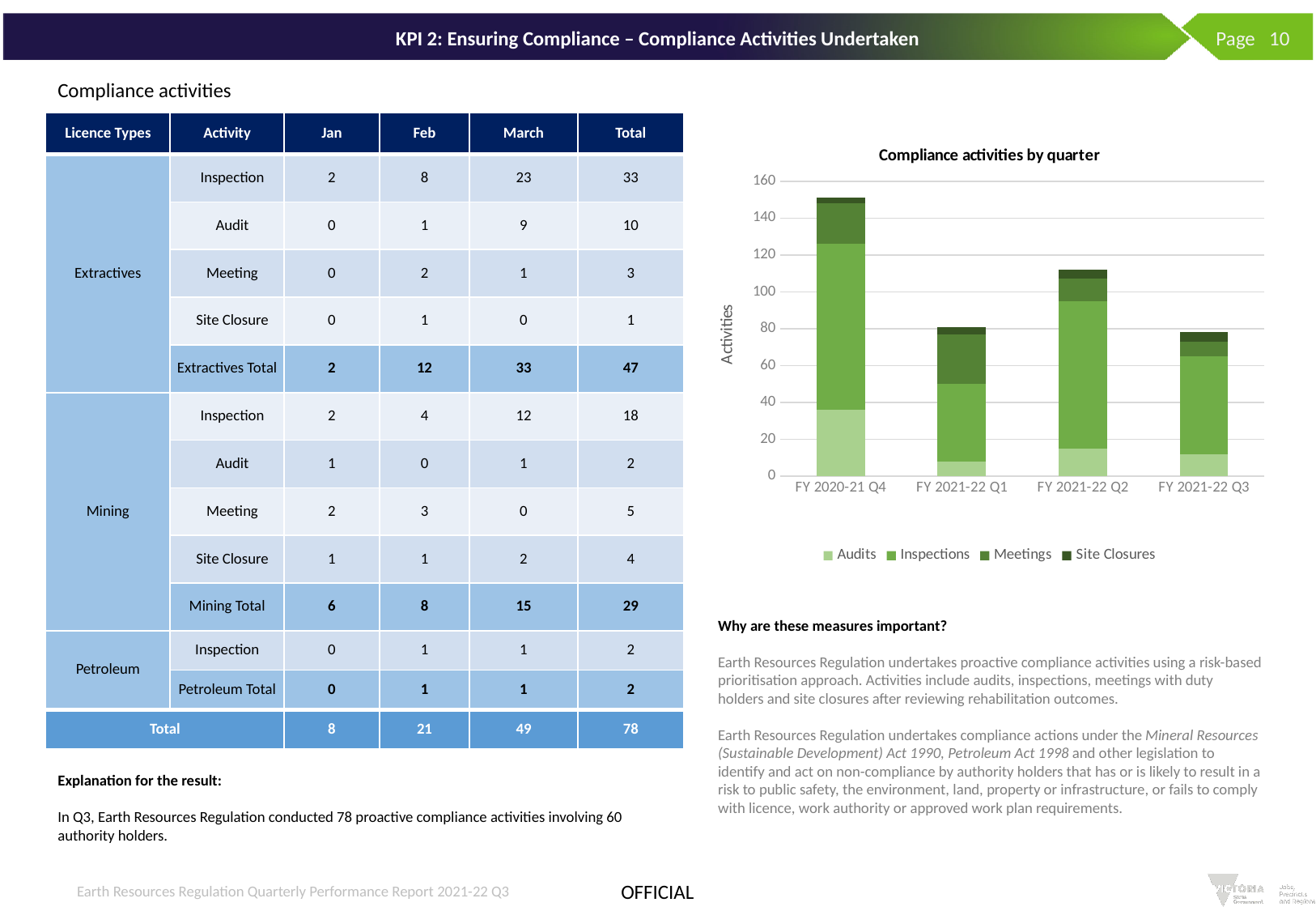
What is the label on the y axis of the chart? Activities Which has the larger total bar, FY 2020-21 Q4 or FY 2021-22 Q2? FY 2020-21 Q4 How many quarters are shown on the x axis of the chart? 4 What is the title of the chart? Compliance activities by quarter How many series does the chart legend list? 4 Is the total bar for FY 2020-21 Q4 greater or less than 140? greater Is the total bar for FY 2021-22 Q2 greater or less than 100? greater Is the Audits segment for FY 2020-21 Q4 greater or less than 20? greater Which has the larger total bar, FY 2021-22 Q1 or FY 2021-22 Q2? FY 2021-22 Q2 What type of chart is shown on the slide? Stacked bar chart Which quarter has the highest total bar in the chart? FY 2020-21 Q4